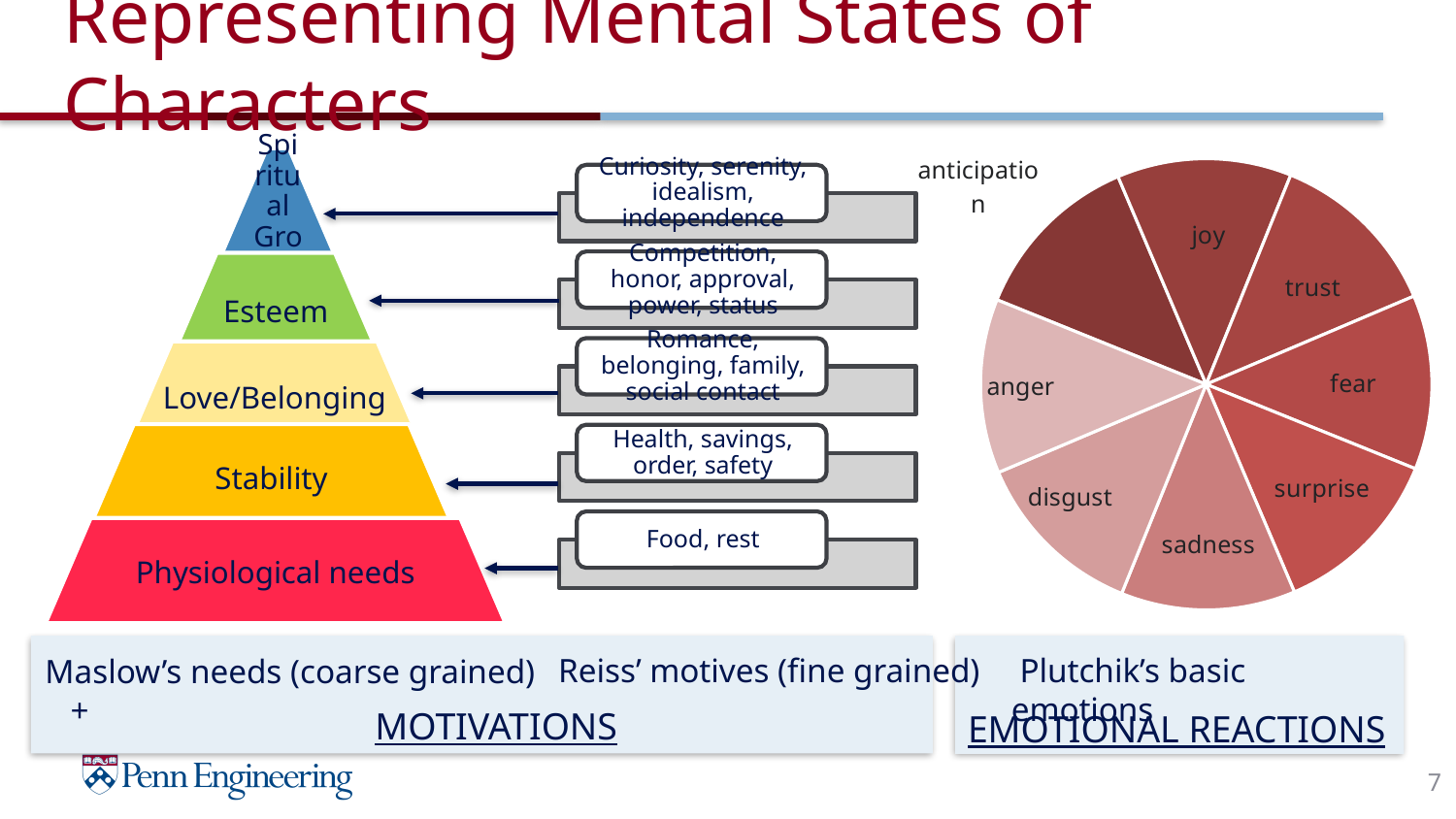
What colour is the Esteem level of the pyramid chart on the left? green In the pie chart on the right, which emotion label is placed outside the pie at the top left? anticipation How many levels does the pyramid chart on the left have? 5 In the pyramid chart on the left, which level is linked to the examples Competition, honor, approval, power, status? Esteem In the pyramid chart on the left, which level is directly above Stability? Love/Belonging What kind of chart is the chart on the right side of the slide showing emotions? pie chart In the pyramid chart on the left, which examples are linked to the Stability level? Health, savings, order, safety What is the label of the bottom level of the pyramid chart on the left? Physiological needs In the pie chart on the right, which emotion is labeled between joy and fear? trust How many slices does the pie chart on the right have? 8 In the pyramid chart on the left, which examples are linked to the Physiological needs level? Food, rest